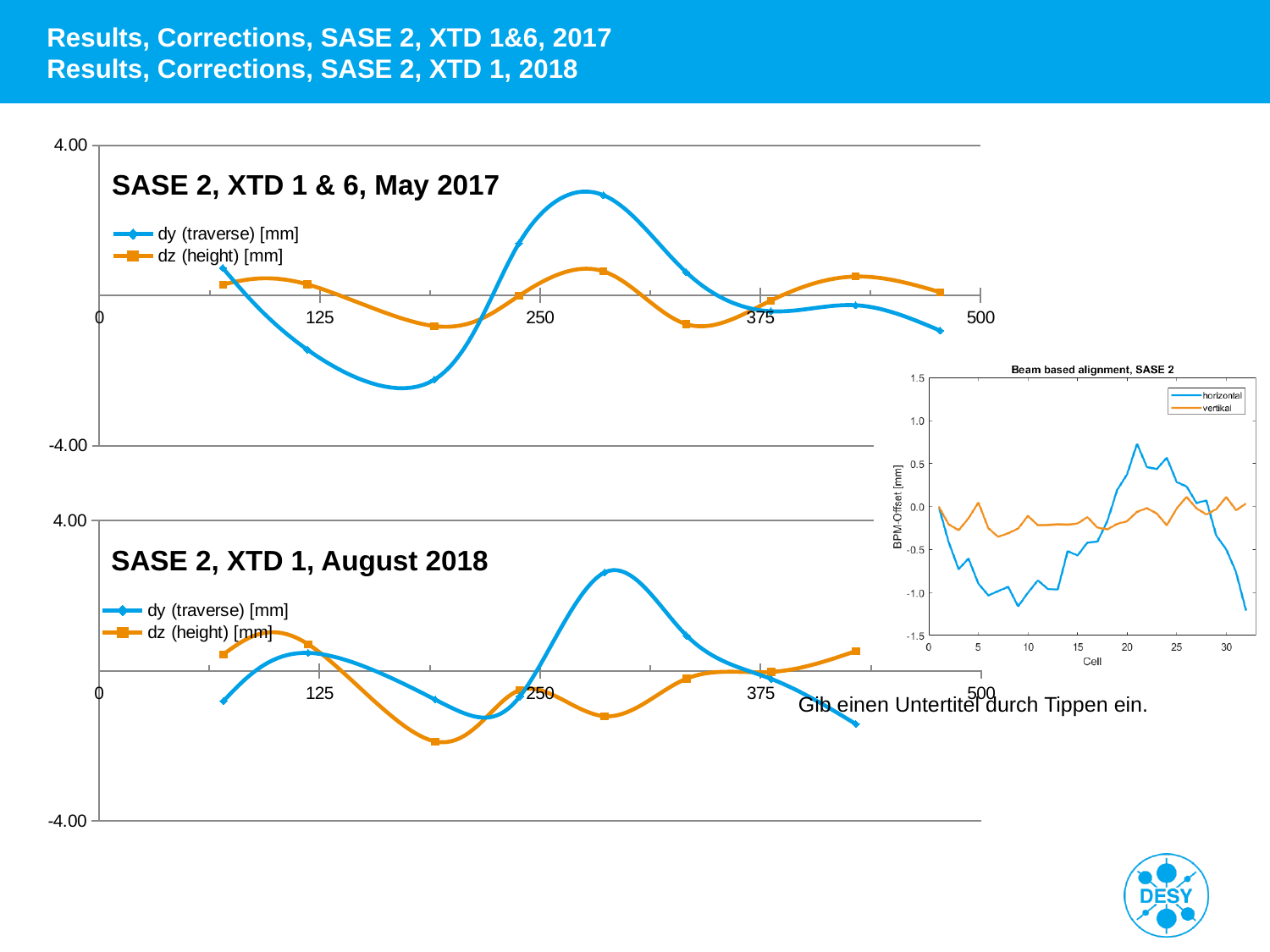
In the 'SASE 2, XTD 1, August 2018' chart, is the dz (height) value at x = 250 greater or less than 0? less How many series does the legend of the 'SASE 2, XTD 1, August 2018' chart list? 2 In the 'SASE 2, XTD 1 & 6, May 2017' chart, is the peak of the dy (traverse) series greater or less than 4.00? less What is the title of the small chart on the right of the slide? Beam based alignment, SASE 2 In the 'SASE 2, XTD 1 & 6, May 2017' chart, is the dy (traverse) value at x = 125 greater or less than 0? less What kind of chart is the 'SASE 2, XTD 1 & 6, May 2017' chart? line chart In the 'SASE 2, XTD 1 & 6, May 2017' chart, which series is drawn in orange? dz (height) [mm] In the 'SASE 2, XTD 1 & 6, May 2017' chart, which series reaches the lowest value? dy (traverse) [mm] How many series does the legend of the 'SASE 2, XTD 1 & 6, May 2017' chart list? 2 In the 'SASE 2, XTD 1 & 6, May 2017' chart, which series reaches the highest value? dy (traverse) [mm] In the 'SASE 2, XTD 1, August 2018' chart, which series reaches the highest value? dy (traverse) [mm]